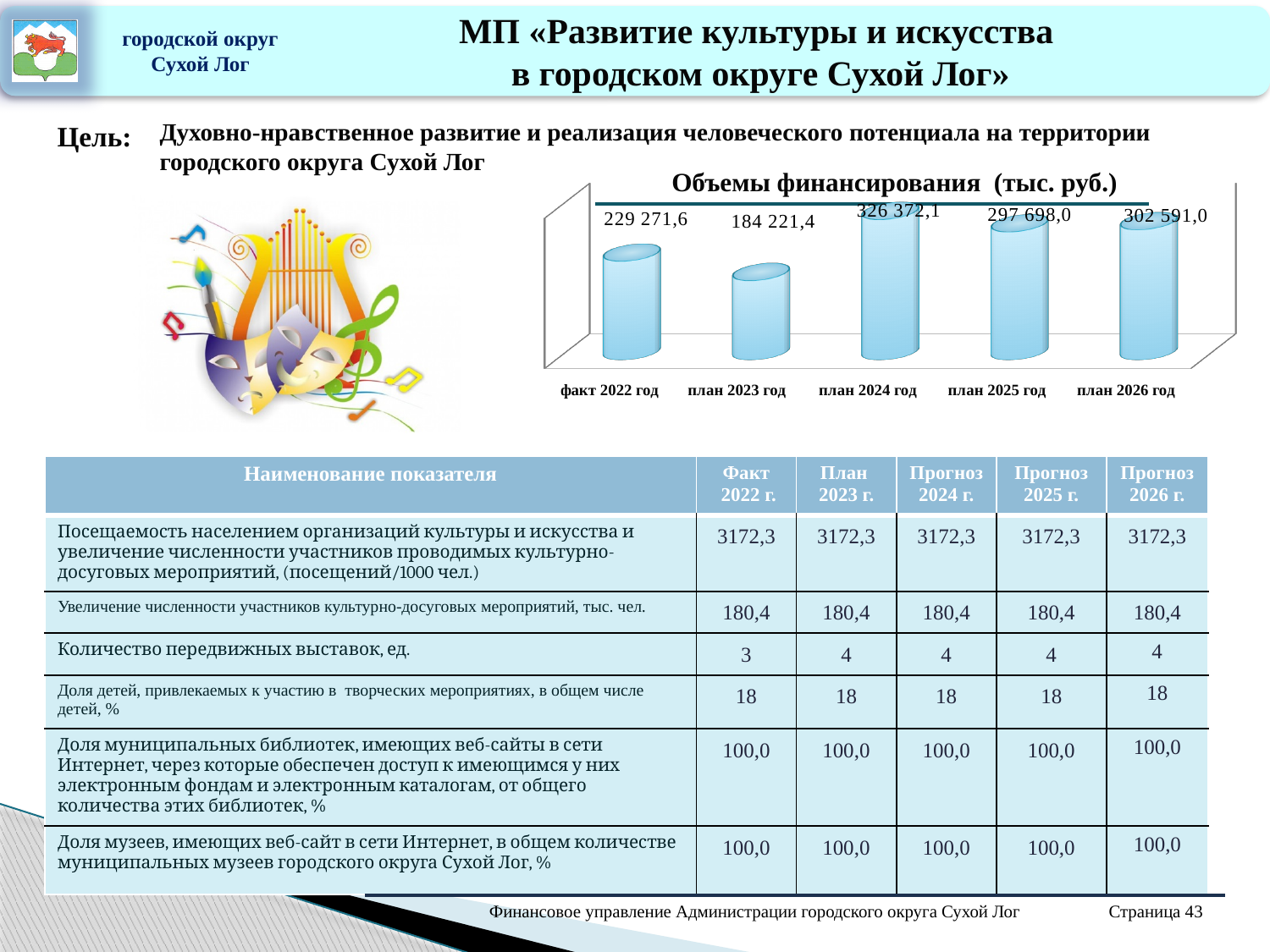
What kind of chart is «Объемы финансирования (тыс. руб.)»? bar chart What is the value for план 2023 год in the chart «Объемы финансирования (тыс. руб.)»? 184 221,4 How many categories are shown in the chart «Объемы финансирования (тыс. руб.)»? 5 Which category has the highest value in the chart «Объемы финансирования (тыс. руб.)»? план 2024 год Which category has the lowest value in the chart «Объемы финансирования (тыс. руб.)»? план 2023 год Does the value rise or fall from план 2023 год to план 2024 год in the chart «Объемы финансирования (тыс. руб.)»? rise What is the value for план 2026 год in the chart «Объемы финансирования (тыс. руб.)»? 302 591,0 What is the difference between the values for факт 2022 год and план 2023 год in the chart «Объемы финансирования (тыс. руб.)»? 45 050,2 What is the difference between the values for план 2024 год and план 2023 год in the chart «Объемы финансирования (тыс. руб.)»? 142 150,7 What is the value for факт 2022 год in the chart «Объемы финансирования (тыс. руб.)»? 229 271,6 What is the value for план 2024 год in the chart «Объемы финансирования (тыс. руб.)»? 326 372,1 Which is larger in the chart «Объемы финансирования (тыс. руб.)»: the value for план 2025 год or the value for факт 2022 год? план 2025 год